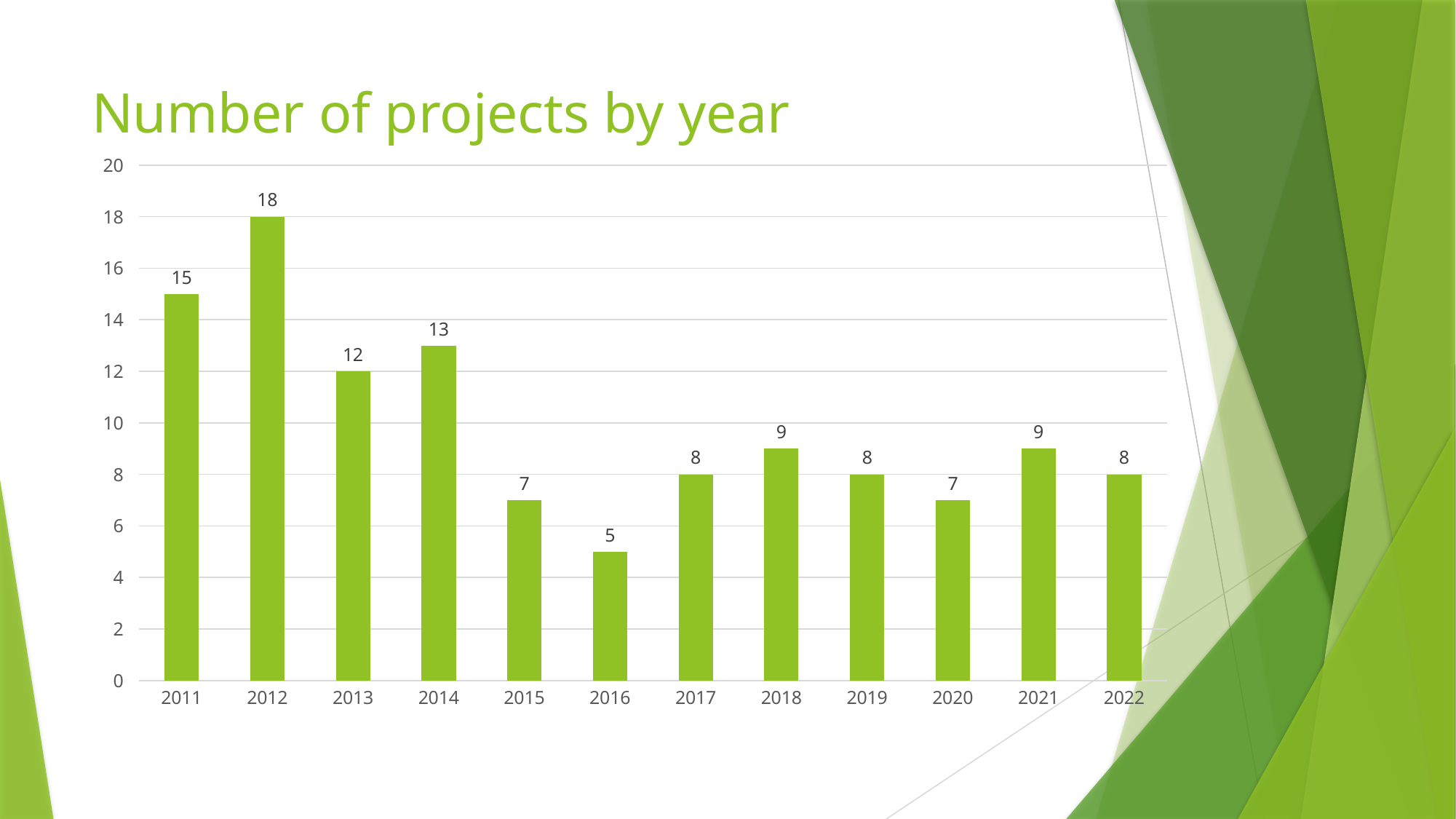
What is the number of projects in 2012? 18 Is the value for 2015 greater or less than 10? less What is the difference between the number of projects in 2011 and 2013? 3 What is the number of projects in 2016? 5 Which year has the highest number of projects? 2012 What is the difference between the number of projects in 2012 and 2016? 13 Which year has more projects, 2014 or 2018? 2014 How many years are shown on the x axis? 12 Which year has the lowest number of projects? 2016 What is the number of projects in 2020? 7 What is the title of the chart? Number of projects by year What kind of chart is shown on the slide? bar chart